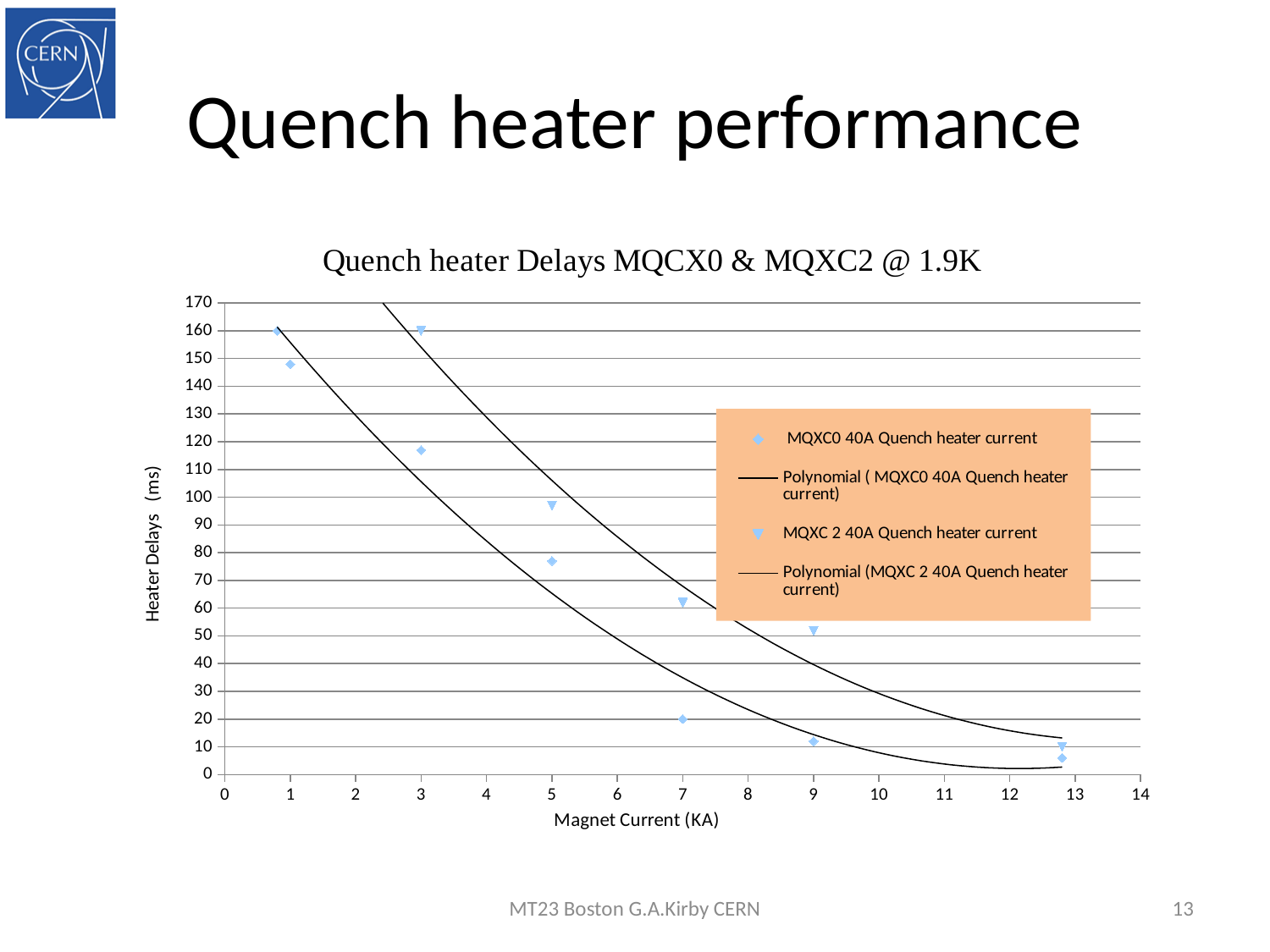
Is the MQXC 2 40A Quench heater current value at 7 kA greater or less than 50? greater Is the MQXC0 40A Quench heater current value at 7 kA greater or less than 30? less What kind of chart is shown on the slide? scatter chart What is the title of the chart? Quench heater Delays MQCX0 & MQXC2 @ 1.9K At 7 kA, which series has the larger heater delay, MQXC0 40A Quench heater current or MQXC 2 40A Quench heater current? MQXC 2 40A Quench heater current Is the MQXC 2 40A Quench heater current value at 9 kA greater or less than 40? greater How many data points are plotted for the MQXC 2 40A Quench heater current series? 5 What is the label of the x axis? Magnet Current (KA) At 9 kA, which series has the larger heater delay, MQXC0 40A Quench heater current or MQXC 2 40A Quench heater current? MQXC 2 40A Quench heater current How many entries does the chart legend list? 4 Do the heater delay values rise or fall as the magnet current increases? fall